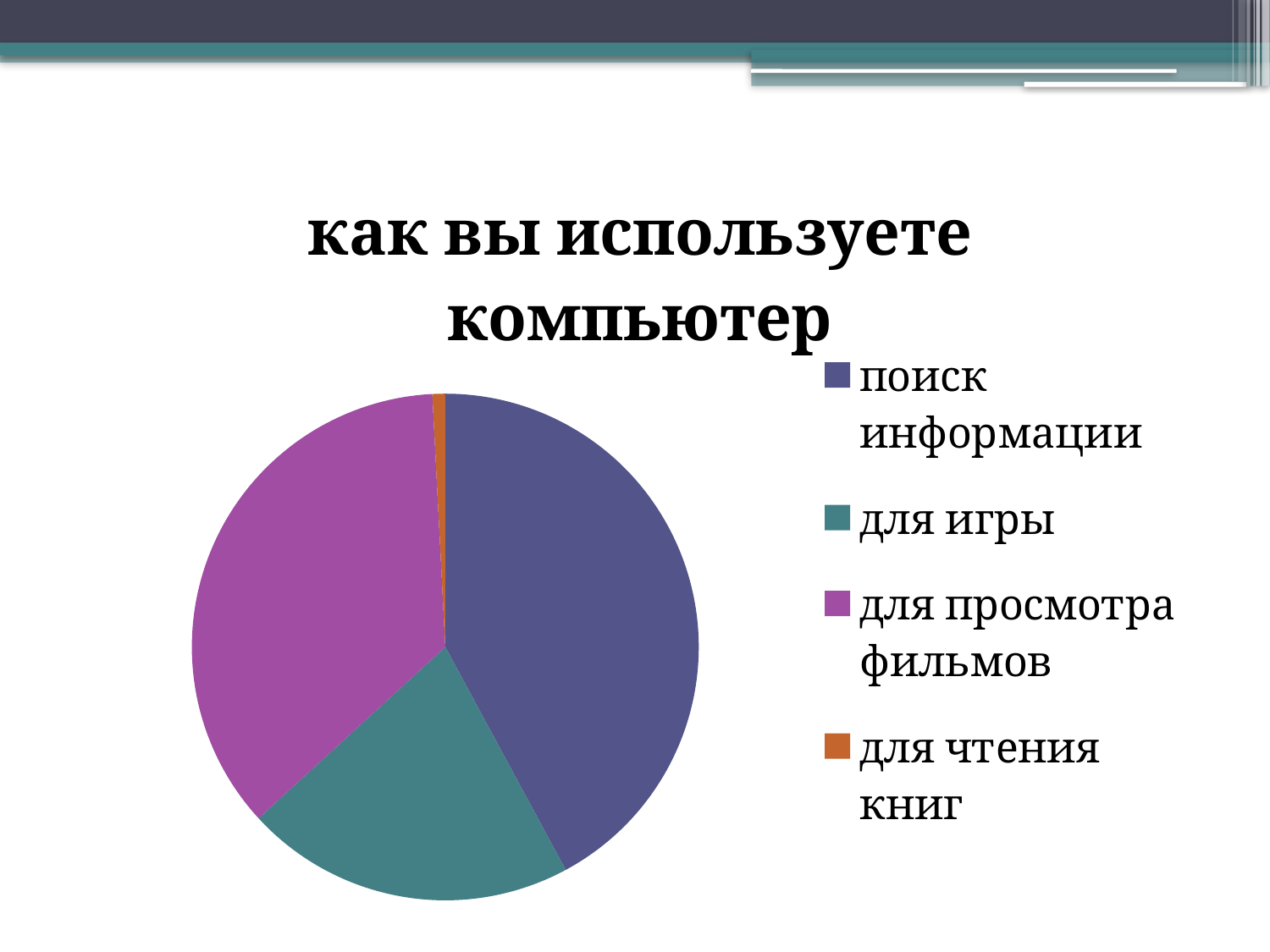
Which category has the smallest slice of the pie? для чтения книг What is the title of the chart? как вы используете компьютер What kind of chart is shown on the slide? pie chart How many categories (slices) does the pie chart have? 4 Which slice is larger: "поиск информации" or "для чтения книг"? поиск информации Which category is shown in orange in the legend? для чтения книг Which slice is larger: "для игры" or "для чтения книг"? для игры How many entries does the legend list? 4 Which slice is larger: "для просмотра фильмов" or "для игры"? для просмотра фильмов